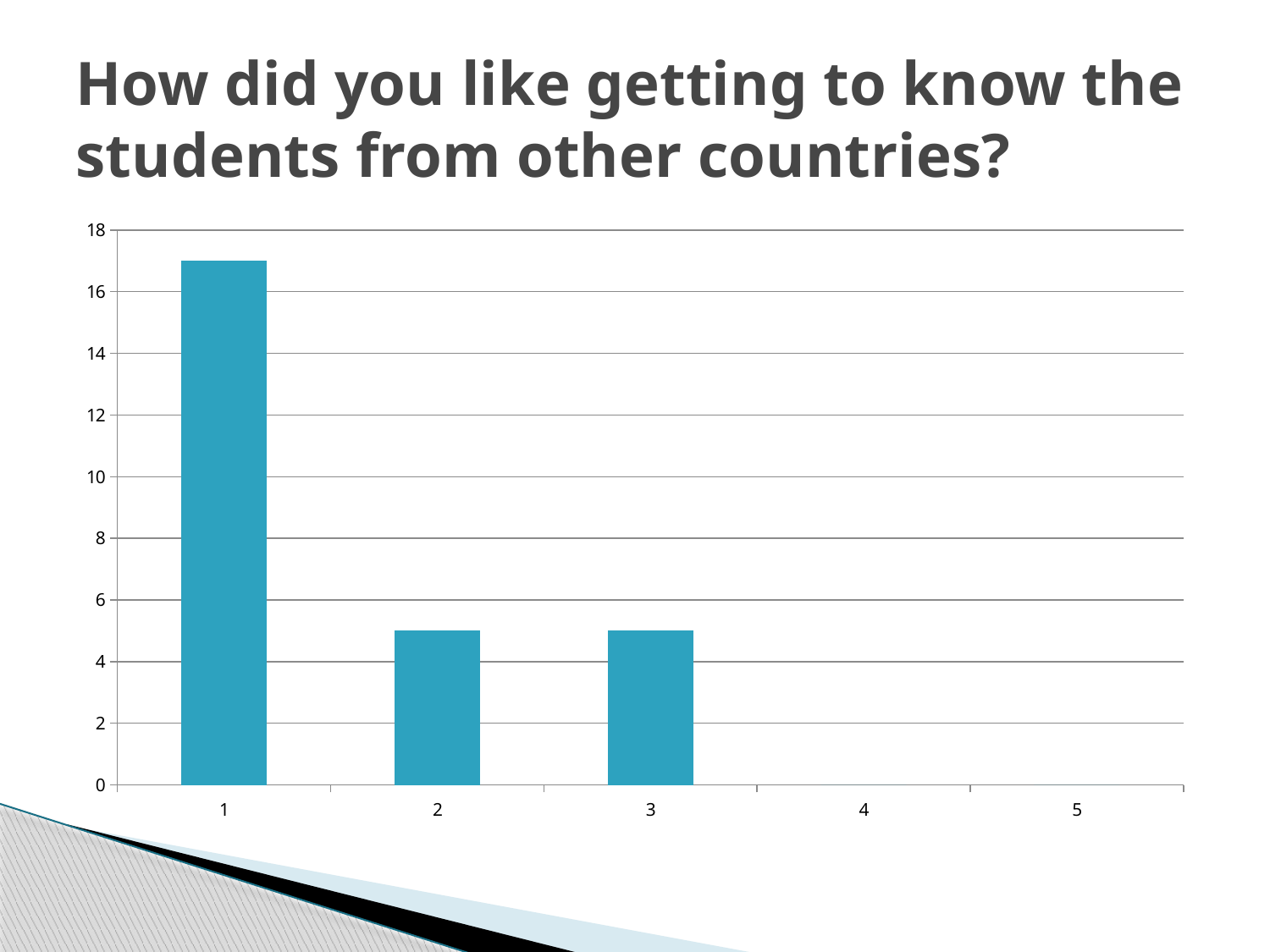
Do the values generally rise or fall from category 1 to category 5? fall Is the value for category 3 greater or less than 6? less What is the value for category 5 in the chart? 0 What is the highest value shown on the vertical axis of the chart? 18 What kind of chart is shown on the slide? bar chart How many categories are shown on the x axis of the chart? 5 Which is larger, the value for category 1 or the value for category 2? category 1 Is the value for category 1 greater or less than 18? less Is the value for category 2 greater or less than 4? greater Which category has the tallest bar in the chart? 1 What is the value for category 4 in the chart? 0